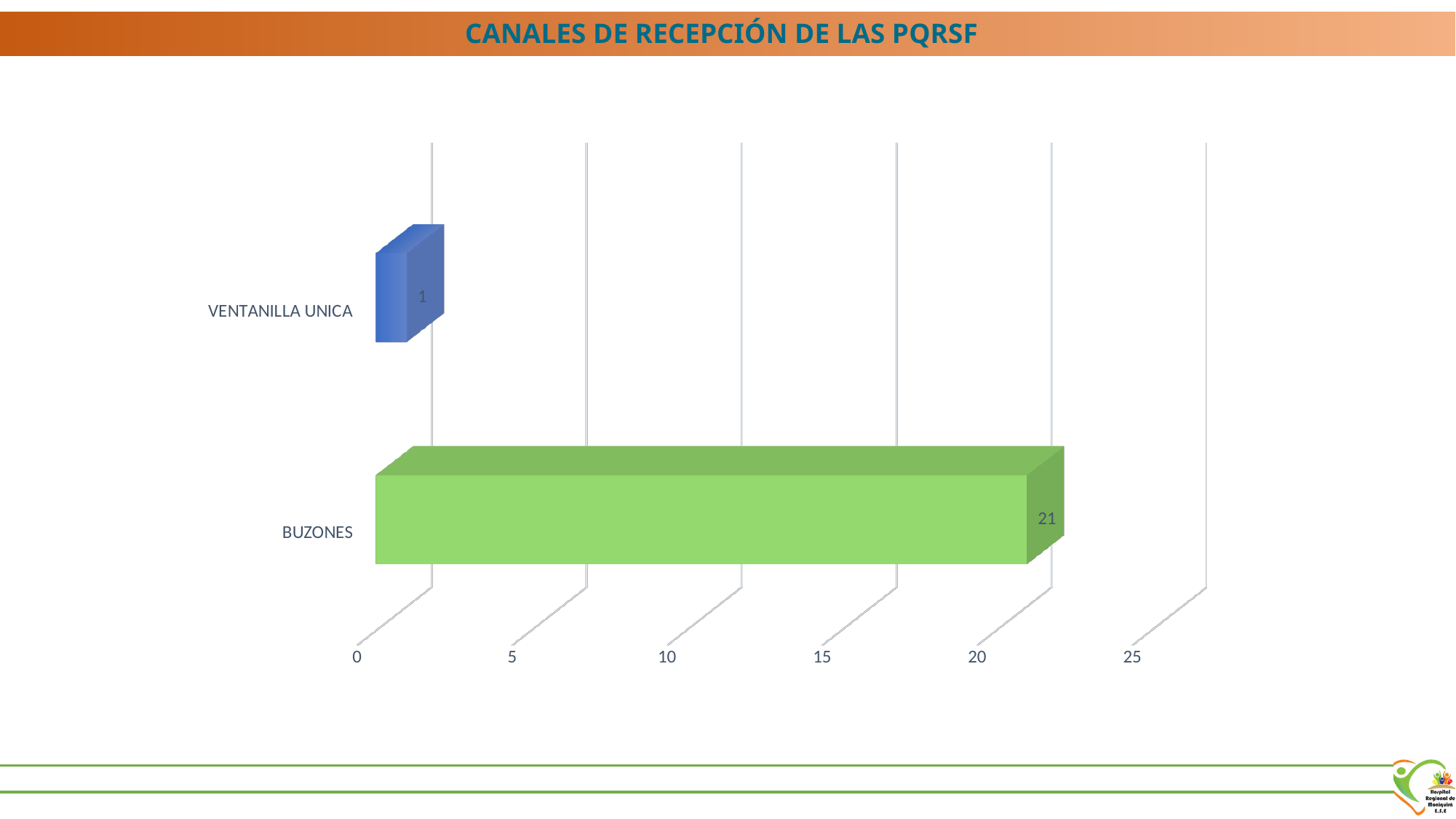
Is the value for VENTANILLA UNICA greater or less than 5? less Which category has the highest value? BUZONES What kind of chart is shown on the slide? Bar chart What colour is the bar for BUZONES? Green Which category has the lowest value? VENTANILLA UNICA What is the title of the slide? CANALES DE RECEPCIÓN DE LAS PQRSF What is the difference between the values for BUZONES and VENTANILLA UNICA? 20 Is the value for BUZONES greater or less than 20? greater What is the value for BUZONES? 21 How many categories are shown in the chart? 2 What is the value for VENTANILLA UNICA? 1 Which is larger, the value for BUZONES or the value for VENTANILLA UNICA? BUZONES